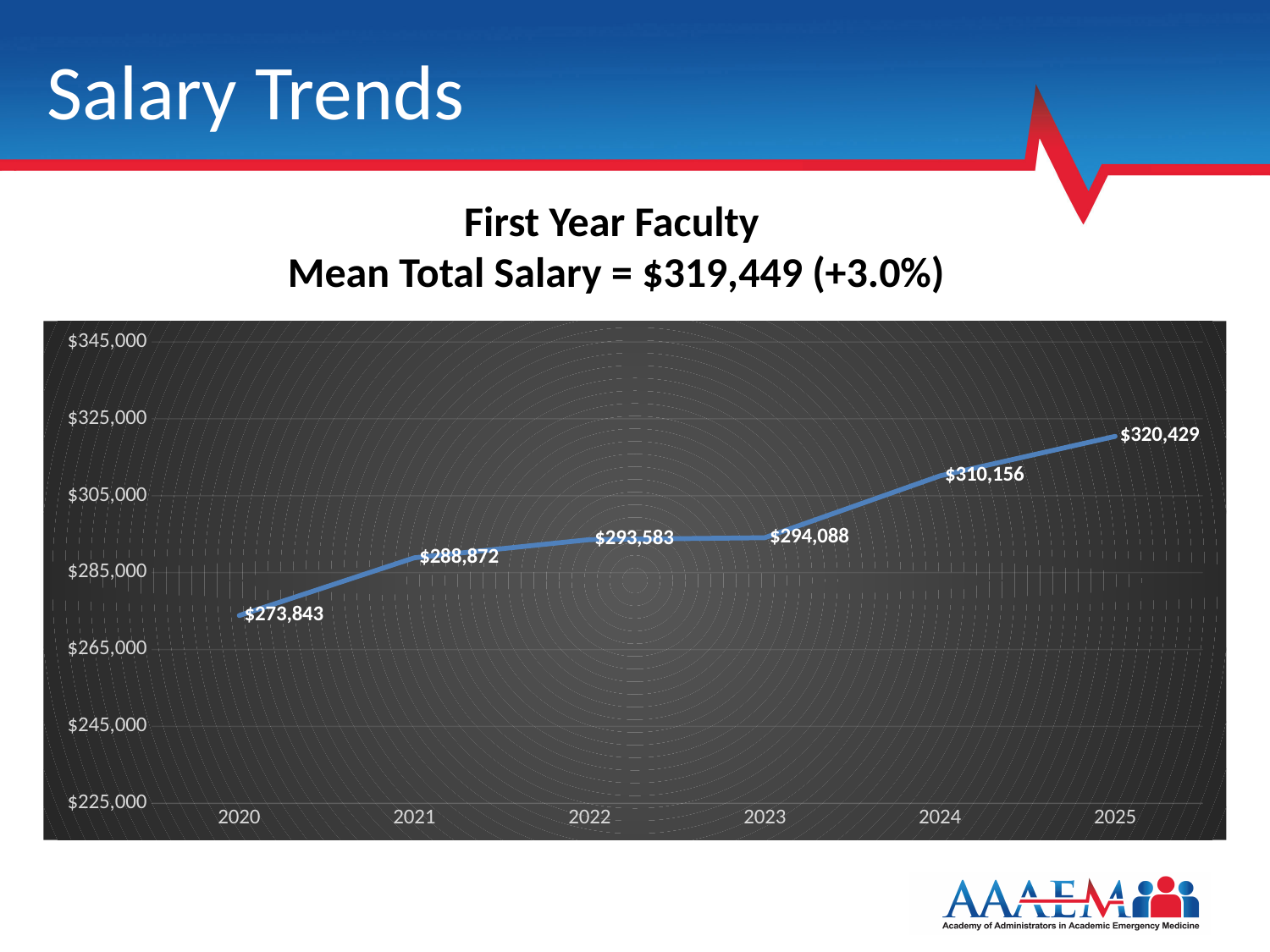
Is the value for 2024 greater or less than $305,000? greater Which year has the highest value on the chart? 2025 What is the value plotted for 2025? $320,429 What kind of chart is shown on the slide? Line chart What is the mean total salary for first year faculty in 2020? $273,843 Which is larger, the value for 2021 or the value for 2024? 2024 What is the difference between the 2025 value and the 2020 value? $46,586 What value is shown for 2023 on the chart? $294,088 By how much did the value increase from 2023 to 2024? $16,068 How many years are plotted on the chart? 6 Do the values rise or fall from 2020 to 2025? Rise Which year has the lowest value on the chart? 2020